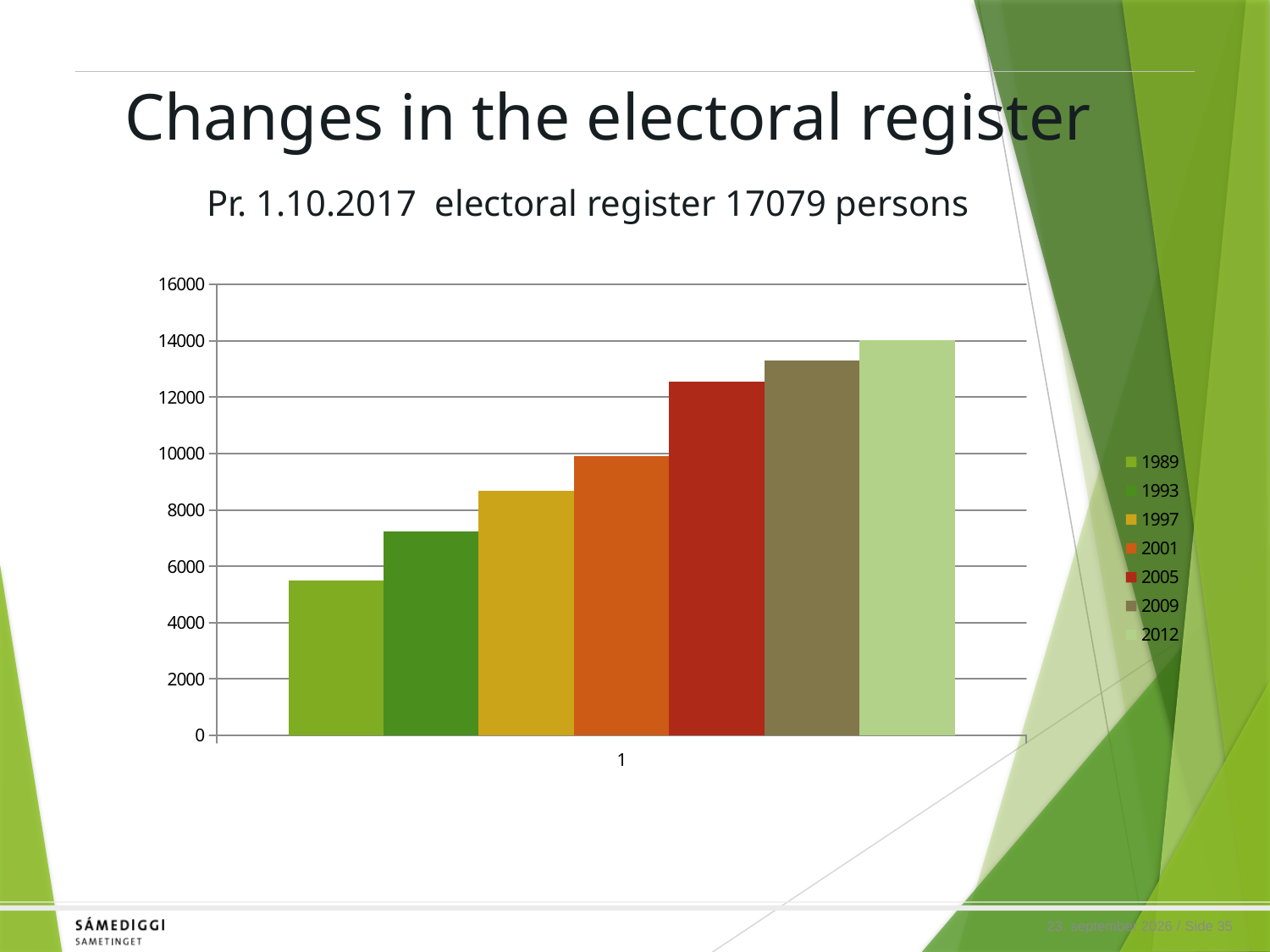
What is the title of the slide containing the chart? Changes in the electoral register Is the value for 2012 greater or less than 16000? less Is the value for 1997 greater or less than 8000? greater Which is larger, the value for 2005 or the value for 1997? 2005 Which year has the lowest bar? 1989 Is the value for 1993 greater or less than 6000? greater Which year has the highest bar? 2012 How many series does the legend list? 7 Do the bars rise or fall from 1989 to 2012? rise What kind of chart is shown on the slide? bar chart